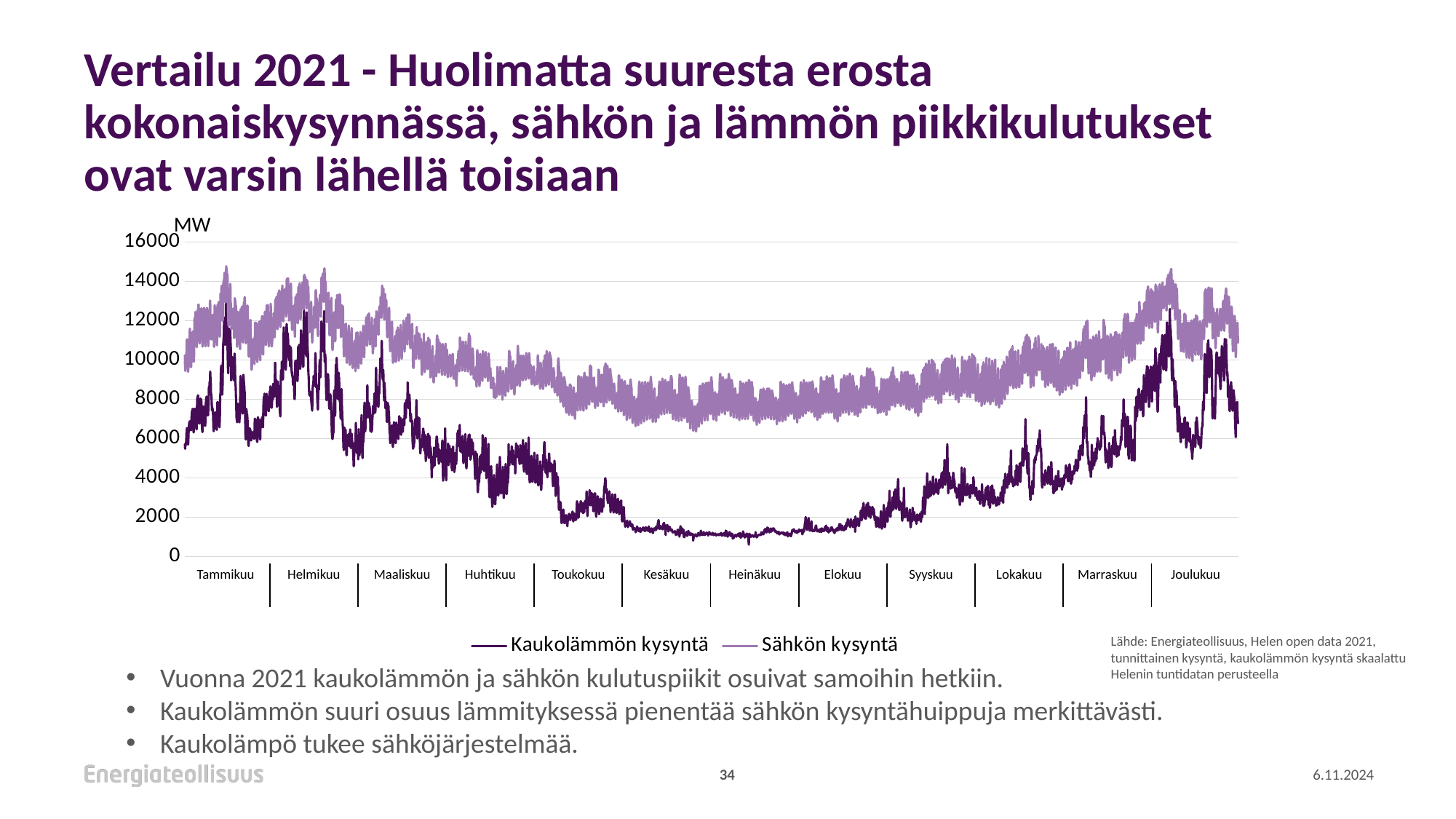
How many months are labelled along the x axis? 12 Is the value of Kaukolämmön kysyntä in Heinäkuu greater or less than 2000? less Does Kaukolämmön kysyntä rise or fall from Elokuu to Joulukuu? Rise Does Kaukolämmön kysyntä rise or fall from Tammikuu to Heinäkuu? Fall How many series does the legend list? 2 What are the two series named in the legend? Kaukolämmön kysyntä and Sähkön kysyntä Is the value of Sähkön kysyntä in Heinäkuu greater or less than 6000? greater Is the highest value of Sähkön kysyntä during the year greater or less than 16000? less What unit is shown on the vertical axis? MW Which series has the higher values in Heinäkuu, Kaukolämmön kysyntä or Sähkön kysyntä? Sähkön kysyntä What kind of chart is shown on the slide? Line chart